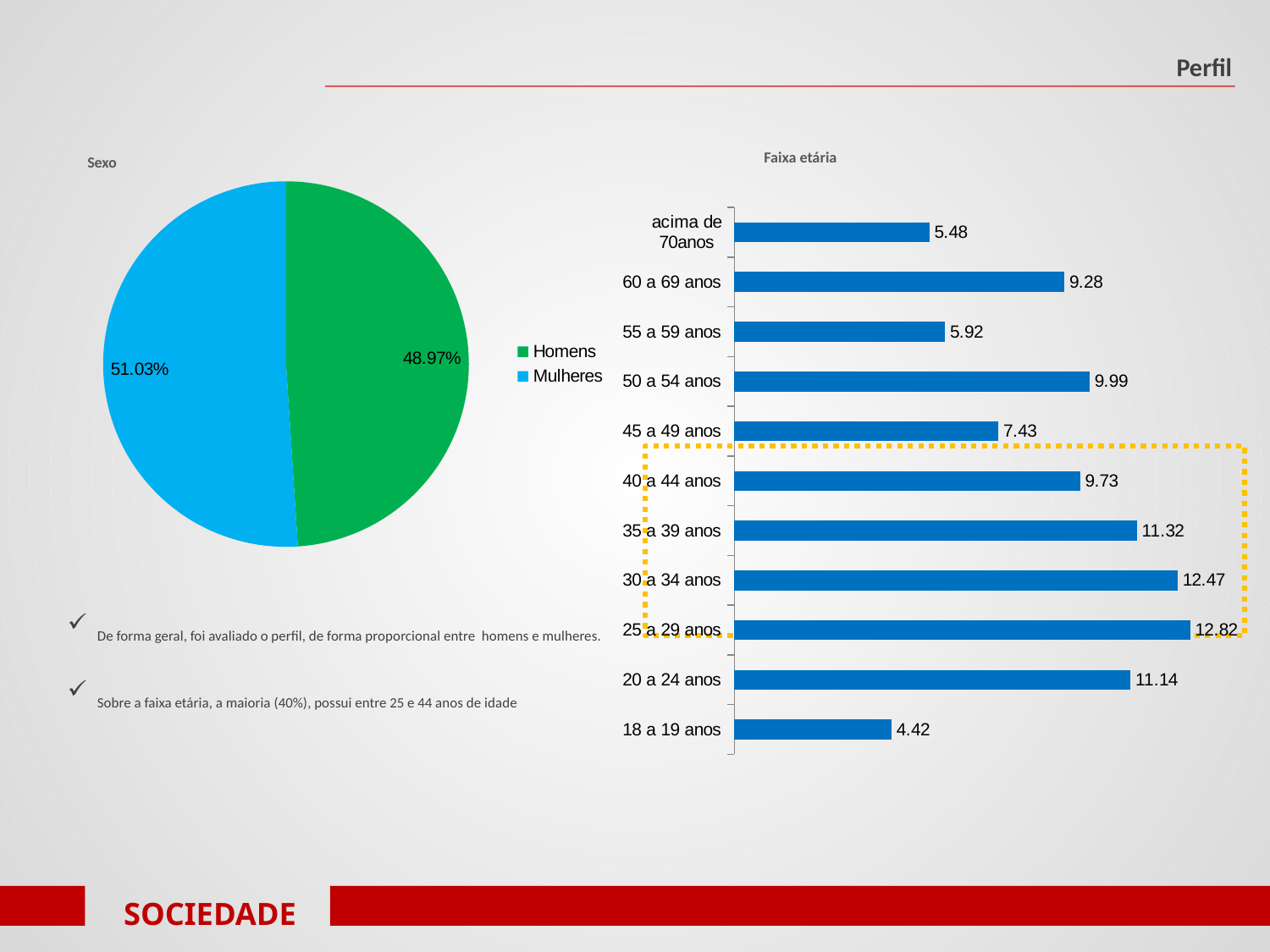
In the 'Faixa etária' chart, which age group has the lowest value? 18 a 19 anos In the 'Sexo' pie chart, what is the share for Homens? 48.97% In the 'Sexo' pie chart, what is the share for Mulheres? 51.03% What kind of chart is the 'Faixa etária' chart? bar chart In the 'Faixa etária' chart, which is larger, the value for 60 a 69 anos or the value for 45 a 49 anos? 60 a 69 anos In the 'Faixa etária' chart, what is the value for 30 a 34 anos? 12.47 In the 'Faixa etária' chart, what is the value for acima de 70anos? 5.48 In the 'Faixa etária' chart, which age group has the highest value? 25 a 29 anos In the 'Faixa etária' chart, what is the difference between the values for 35 a 39 anos and 55 a 59 anos? 5.40 How many entries does the legend of the 'Sexo' pie chart list? 2 In the 'Sexo' pie chart, which group has the larger share, Homens or Mulheres? Mulheres How many age groups are shown in the 'Faixa etária' chart? 11